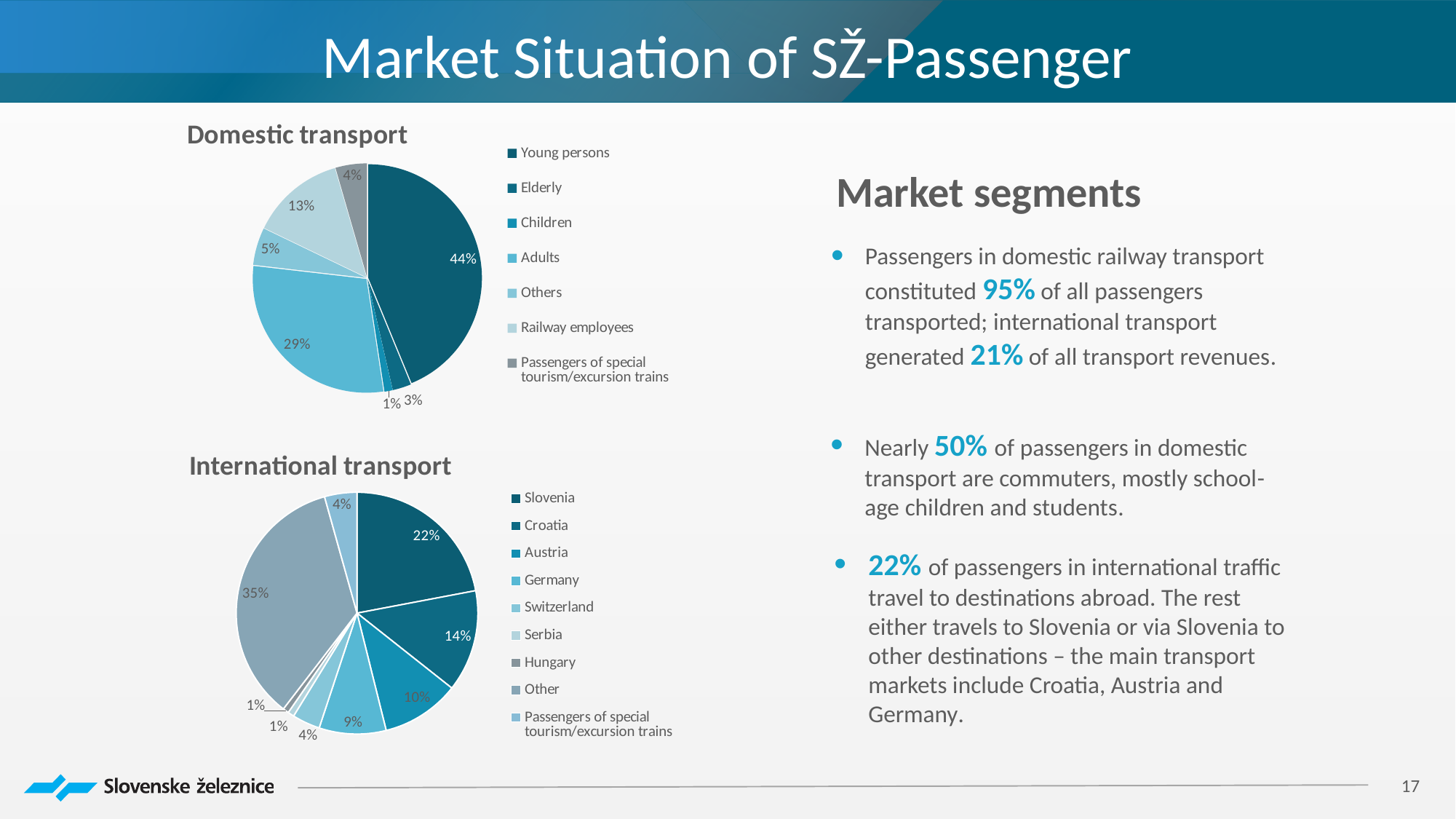
What kind of chart is used for Domestic transport on this slide? Pie chart In the Domestic transport pie chart, what share do Young persons account for? 44% In the International transport pie chart, which has the larger share, Austria or Germany? Austria In the International transport pie chart, what share is labelled for Other? 35% In the International transport pie chart, which category has the largest slice? Other In the Domestic transport pie chart, which category has the largest slice? Young persons In the Domestic transport pie chart, how much larger is the Young persons share than the Adults share? 15% In the International transport pie chart, what is the share for Croatia? 14% In the International transport pie chart, what is the difference between the Slovenia share and the Croatia share? 8% How many categories does the Domestic transport pie chart's legend list? 7 In the Domestic transport pie chart, what is the share for Adults? 29% How many categories does the International transport pie chart's legend list? 9